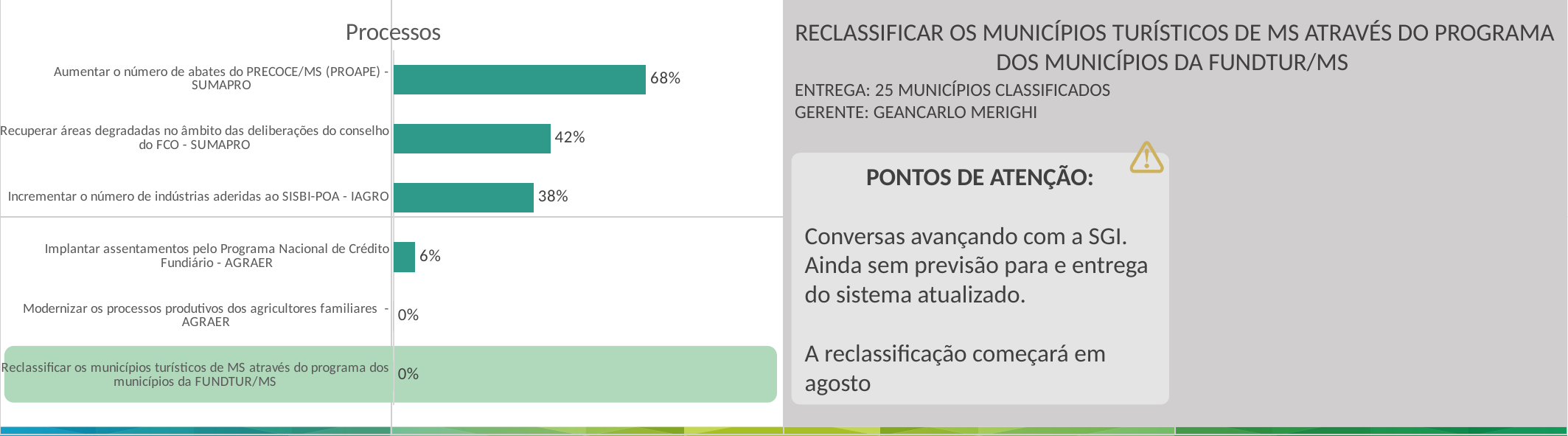
What is the value for "Incrementar o número de indústrias aderidas ao SISBI-POA - IAGRO"? 38% What is the value for "Reclassificar os municípios turísticos de MS através do programa dos municípios da FUNDTUR/MS"? 0% How many categories in the chart have a value of 0%? 2 What is the value for "Aumentar o número de abates do PRECOCE/MS (PROAPE) - SUMAPRO"? 68% Which category has the highest value? Aumentar o número de abates do PRECOCE/MS (PROAPE) - SUMAPRO What kind of chart is shown on the slide? bar chart What is the value for "Recuperar áreas degradadas no âmbito das deliberações do conselho do FCO - SUMAPRO"? 42% Which is larger, the value for "Recuperar áreas degradadas no âmbito das deliberações do conselho do FCO - SUMAPRO" or the value for "Incrementar o número de indústrias aderidas ao SISBI-POA - IAGRO"? Recuperar áreas degradadas no âmbito das deliberações do conselho do FCO - SUMAPRO What is the difference between the values for "Aumentar o número de abates do PRECOCE/MS (PROAPE) - SUMAPRO" and "Recuperar áreas degradadas no âmbito das deliberações do conselho do FCO - SUMAPRO"? 26% What is the value for "Implantar assentamentos pelo Programa Nacional de Crédito Fundiário - AGRAER"? 6% How many categories does the chart show? 6 What is the title of the chart? Processos